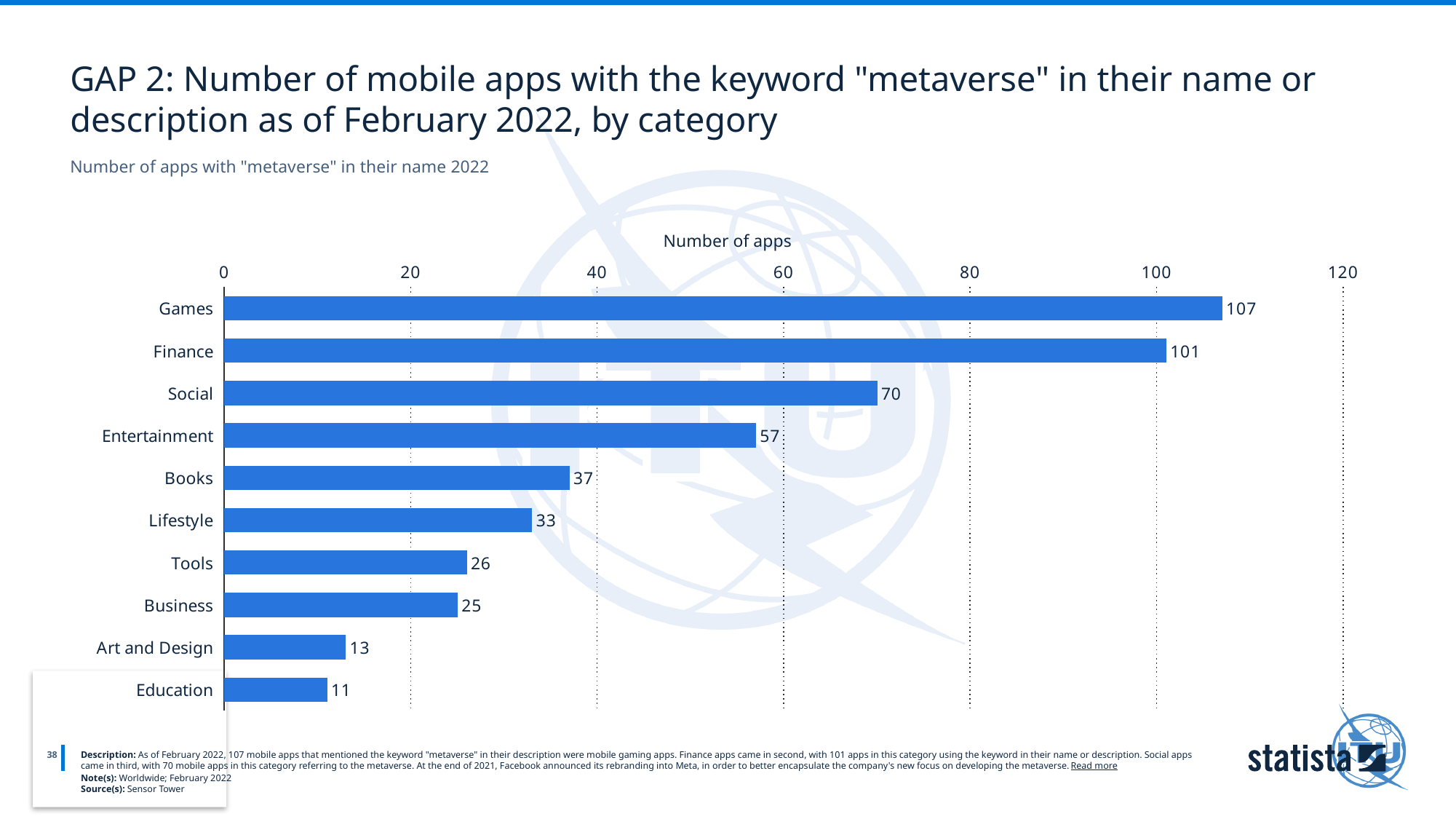
What is the number of apps for the Education category? 11 Which category has the lowest number of apps? Education How many apps with "metaverse" in their name or description are in the Games category? 107 What is the number of apps for the Finance category? 101 Which category has the highest number of apps? Games What is the difference between the number of apps for Social and Books? 33 How many categories are shown in the chart? 10 Which category has more apps, Lifestyle or Tools? Lifestyle What kind of chart is shown on the slide? Bar chart What is the number of apps for the Entertainment category? 57 What is the difference between the number of apps for Games and Finance? 6 What is the title of the horizontal axis? Number of apps